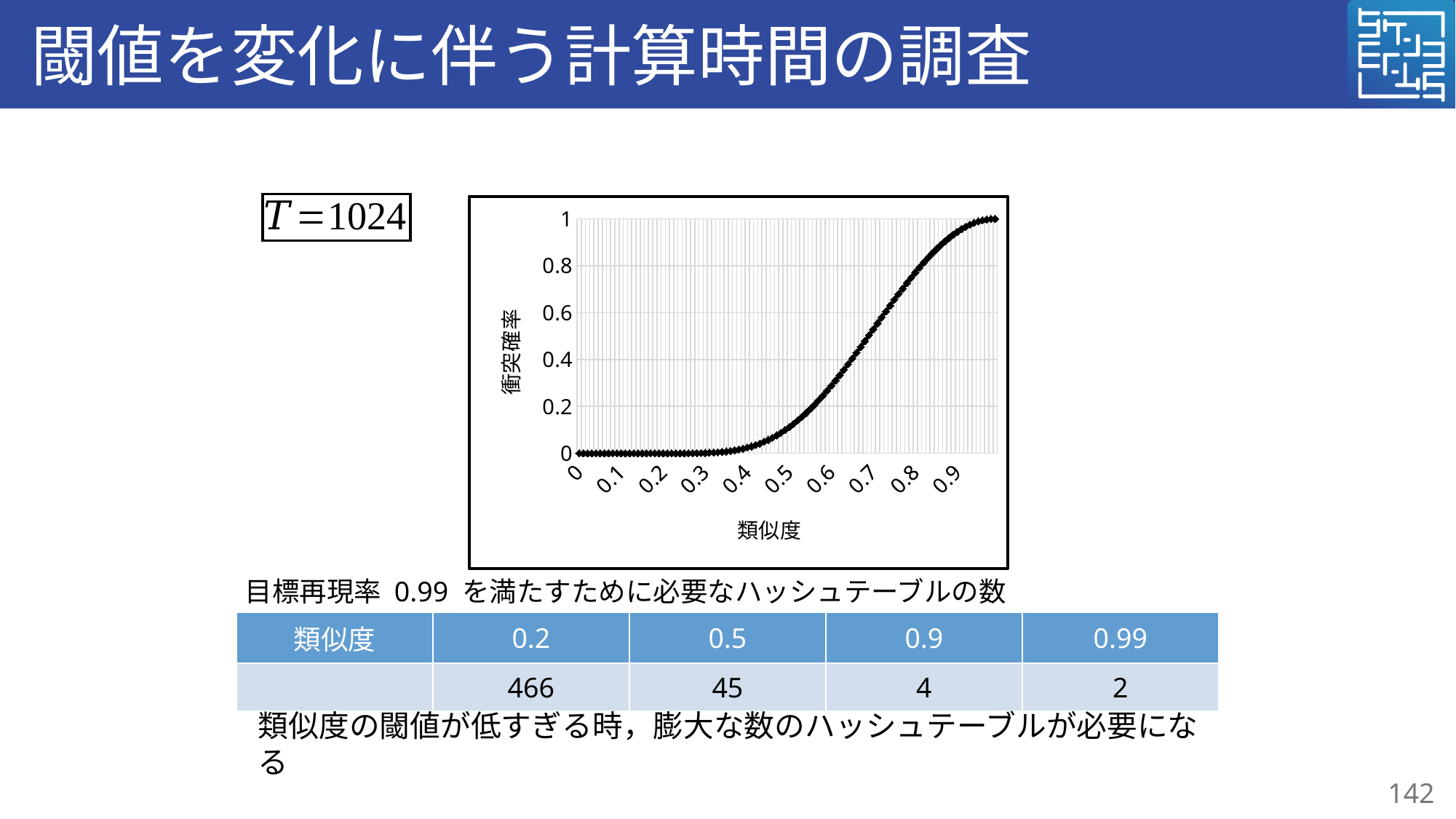
What is the label of the y axis of the chart? 衝突確率 What kind of chart is shown on the slide? line chart Is the value of 衝突確率 at 類似度 0.5 greater or less than 0.4? less Is the value of 衝突確率 at 類似度 0.9 greater or less than 0.8? greater Is the value of 衝突確率 at 類似度 0.3 greater or less than 0.2? less What is the label of the x axis of the chart? 類似度 What is the highest tick value shown on the y axis of the chart? 1 Which has the larger 衝突確率 value, 類似度 0.4 or 類似度 0.8? 0.8 Do the plotted values rise or fall as 類似度 increases along the x axis? rise